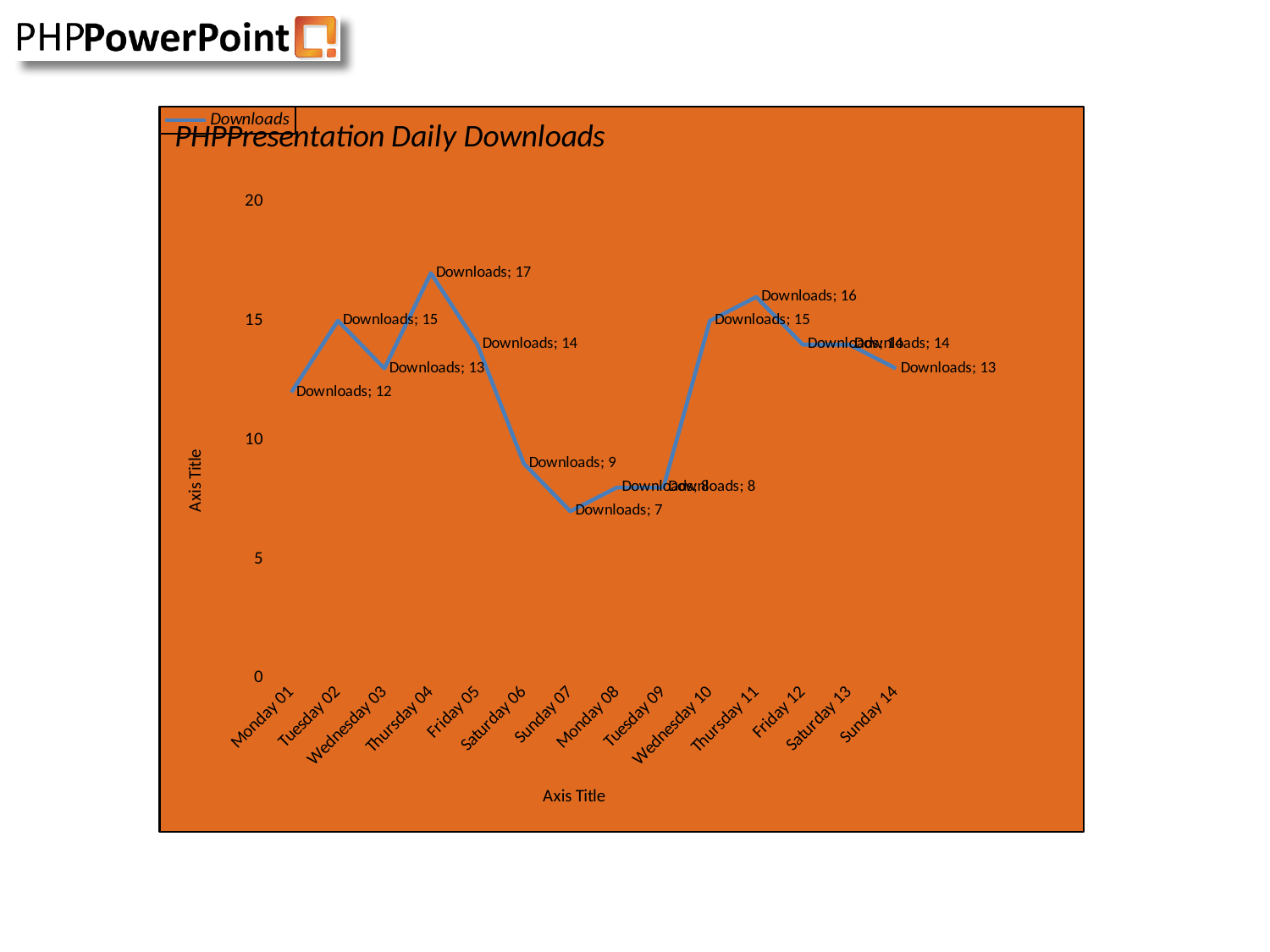
What is the Downloads value for Thursday 04? 17 How many series does the legend list? 1 What is the Downloads value for Sunday 07? 7 Do the Downloads values rise or fall from Thursday 04 to Sunday 07? fall Which day has the highest Downloads value? Thursday 04 Which day has the lowest Downloads value? Sunday 07 What is the difference between the Downloads values for Thursday 04 and Sunday 07? 10 What is the Downloads value for Monday 01? 12 What type of chart is shown on the slide? line chart How many categories are plotted along the x axis? 14 What is the title of the chart? PHPPresentation Daily Downloads Which has a larger Downloads value, Tuesday 02 or Wednesday 03? Tuesday 02